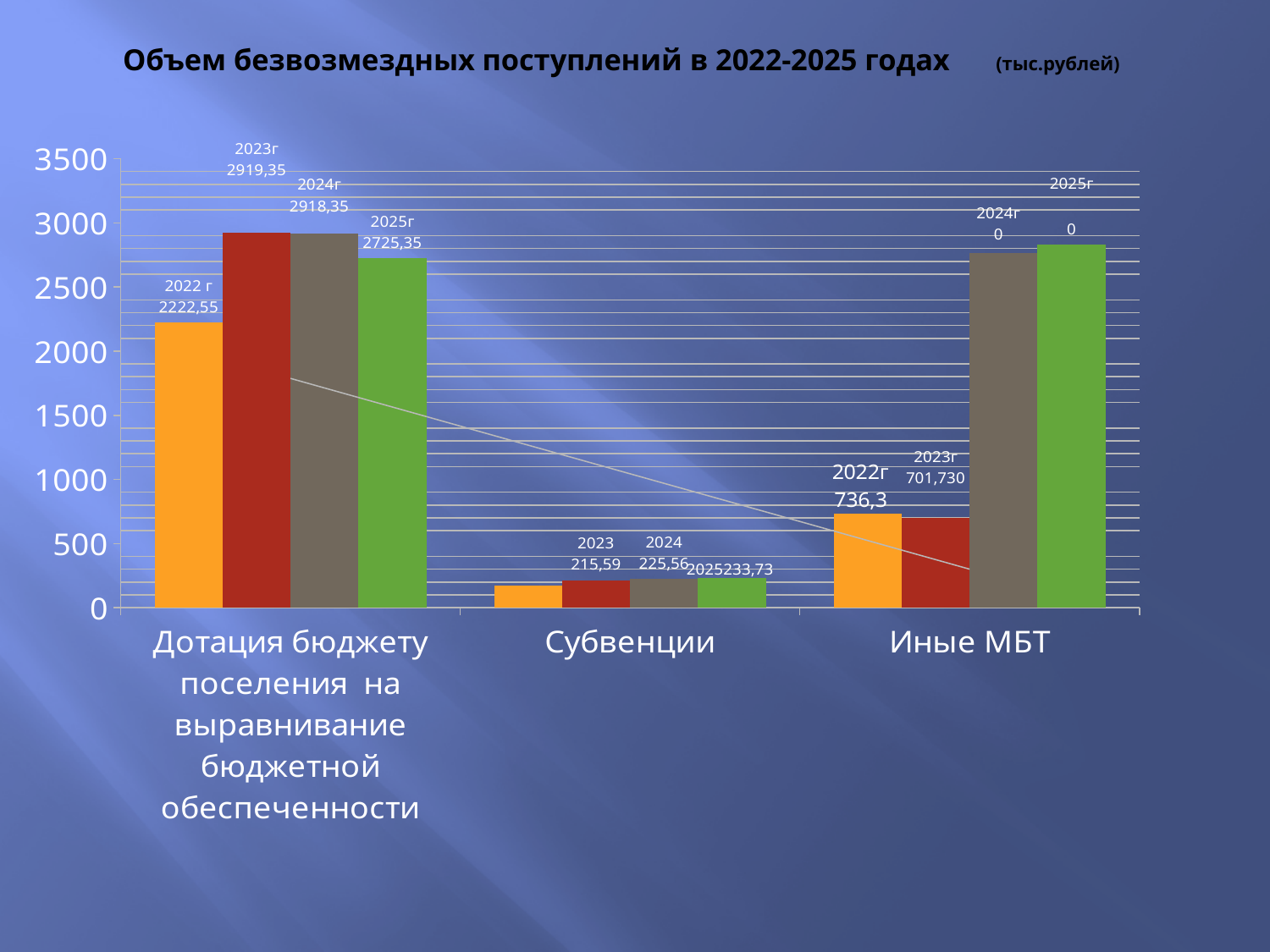
In the 'Субвенции' category, which is larger: the 2023 value or the 2025 value? 2025 Which year has the lowest value in the 'Дотация бюджету поселения на выравнивание бюджетной обеспеченности' category? 2022 What is the value for 2023 in the 'Дотация бюджету поселения на выравнивание бюджетной обеспеченности' category? 2919,35 What is the value for 2023 in the 'Иные МБТ' category? 701,730 What kind of chart is shown on the slide? bar chart What is the value for 2022 in the 'Иные МБТ' category? 736,3 What is the value for 2025 in the 'Дотация бюджету поселения на выравнивание бюджетной обеспеченности' category? 2725,35 What is the value for 2024 in the 'Субвенции' category? 225,56 How many categories are shown on the x axis? 3 What is the value for 2022 in the 'Дотация бюджету поселения на выравнивание бюджетной обеспеченности' category? 2222,55 Is the value for 2022 in the 'Субвенции' category greater or less than 500? less What is the difference between the 2023 and 2022 values in the 'Дотация бюджету поселения на выравнивание бюджетной обеспеченности' category? 696,80